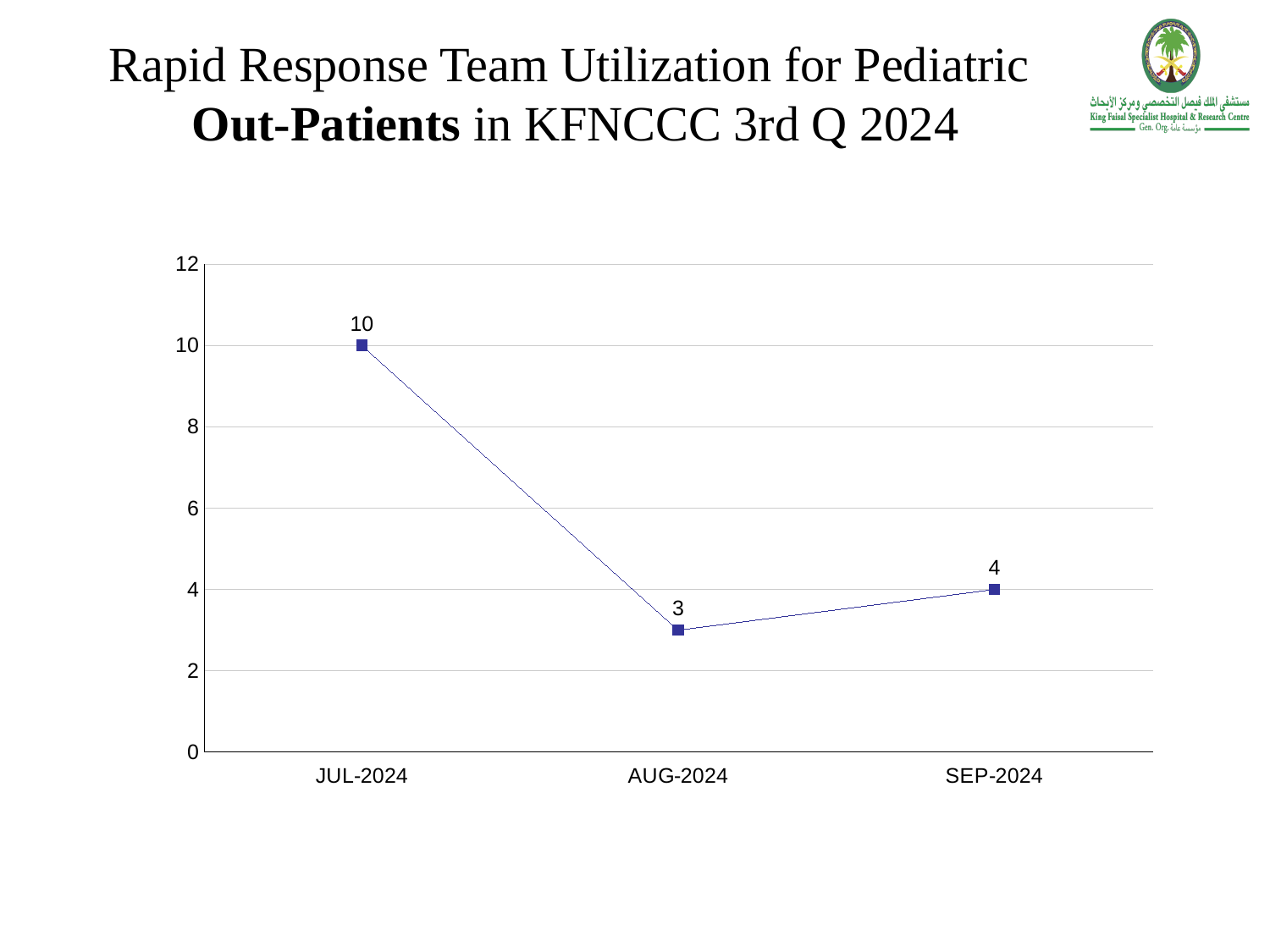
Which month has the highest value? JUL-2024 What is the value for JUL-2024? 10 Which is larger, the value for JUL-2024 or the value for SEP-2024? JUL-2024 How many months are plotted on the chart? 3 What is the difference between the values for JUL-2024 and AUG-2024? 7 What kind of chart is shown on the slide? line chart Which month has the lowest value? AUG-2024 Does the value rise or fall from JUL-2024 to AUG-2024? fall What is the value for AUG-2024? 3 What is the value for SEP-2024? 4 Is the value for JUL-2024 greater or less than 8? greater What is the difference between the values for SEP-2024 and AUG-2024? 1